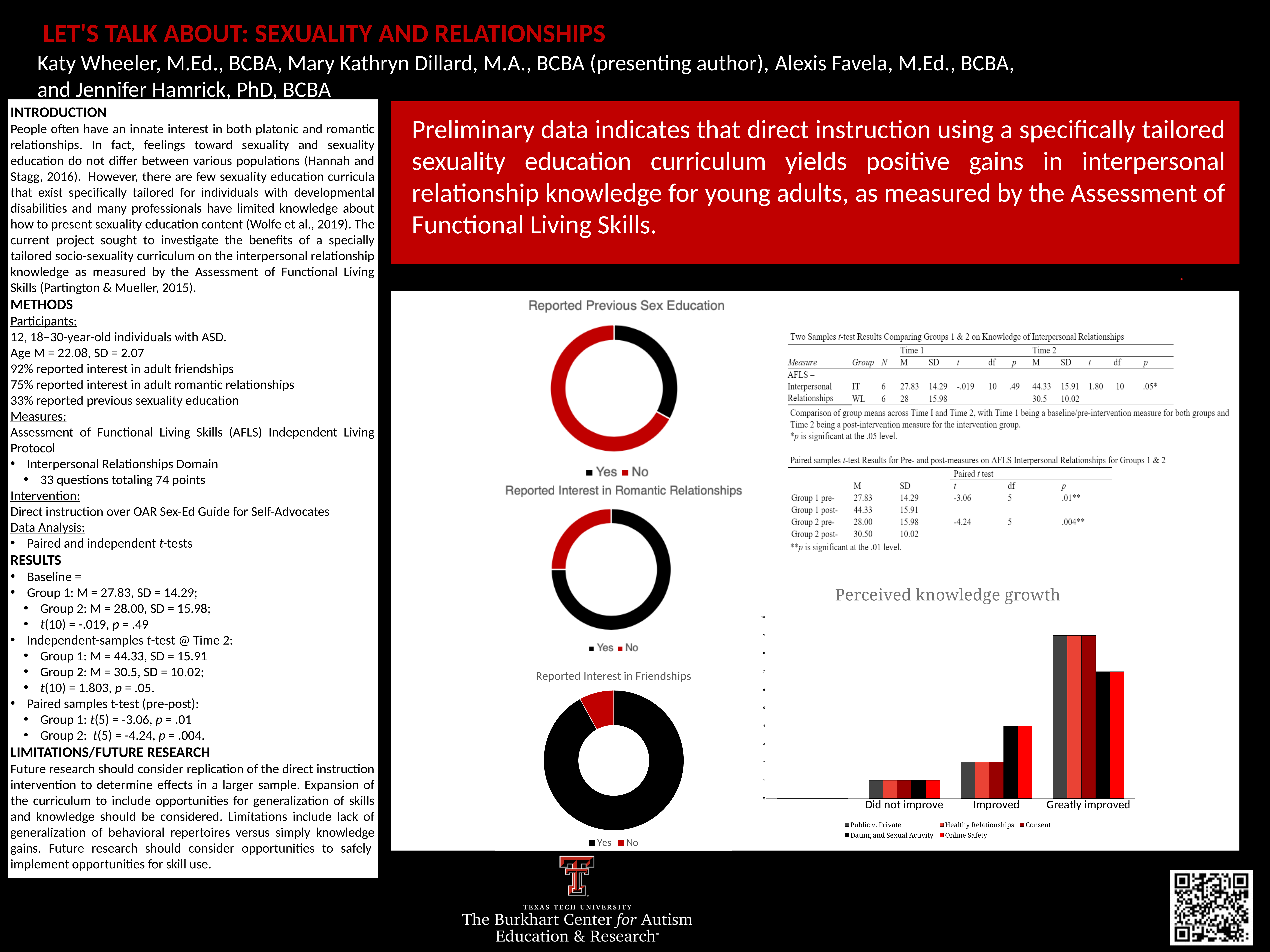
What kind of chart is the "Reported Previous Sex Education" chart? donut chart What kind of chart is the "Perceived knowledge growth" chart? bar chart In the "Perceived knowledge growth" chart, which is larger in the "Greatly improved" category: Consent or Online Safety? Consent What two legend entries are shown for the "Reported Interest in Romantic Relationships" chart? Yes and No How many categories are shown on the x axis of the "Perceived knowledge growth" chart? 3 In the "Perceived knowledge growth" chart, which category has the tallest bars? Greatly improved In the "Perceived knowledge growth" chart, which category has the shortest bars? Did not improve In the "Perceived knowledge growth" chart, is the value for Consent in the "Improved" category greater or less than 3? less In the "Reported Previous Sex Education" chart, which slice is larger: Yes or No? No How many series does the legend of the "Perceived knowledge growth" chart list? 5 In the "Perceived knowledge growth" chart, is the value for Online Safety in the "Greatly improved" category greater or less than 5? greater In the "Reported Interest in Friendships" chart, which slice is larger: Yes or No? Yes